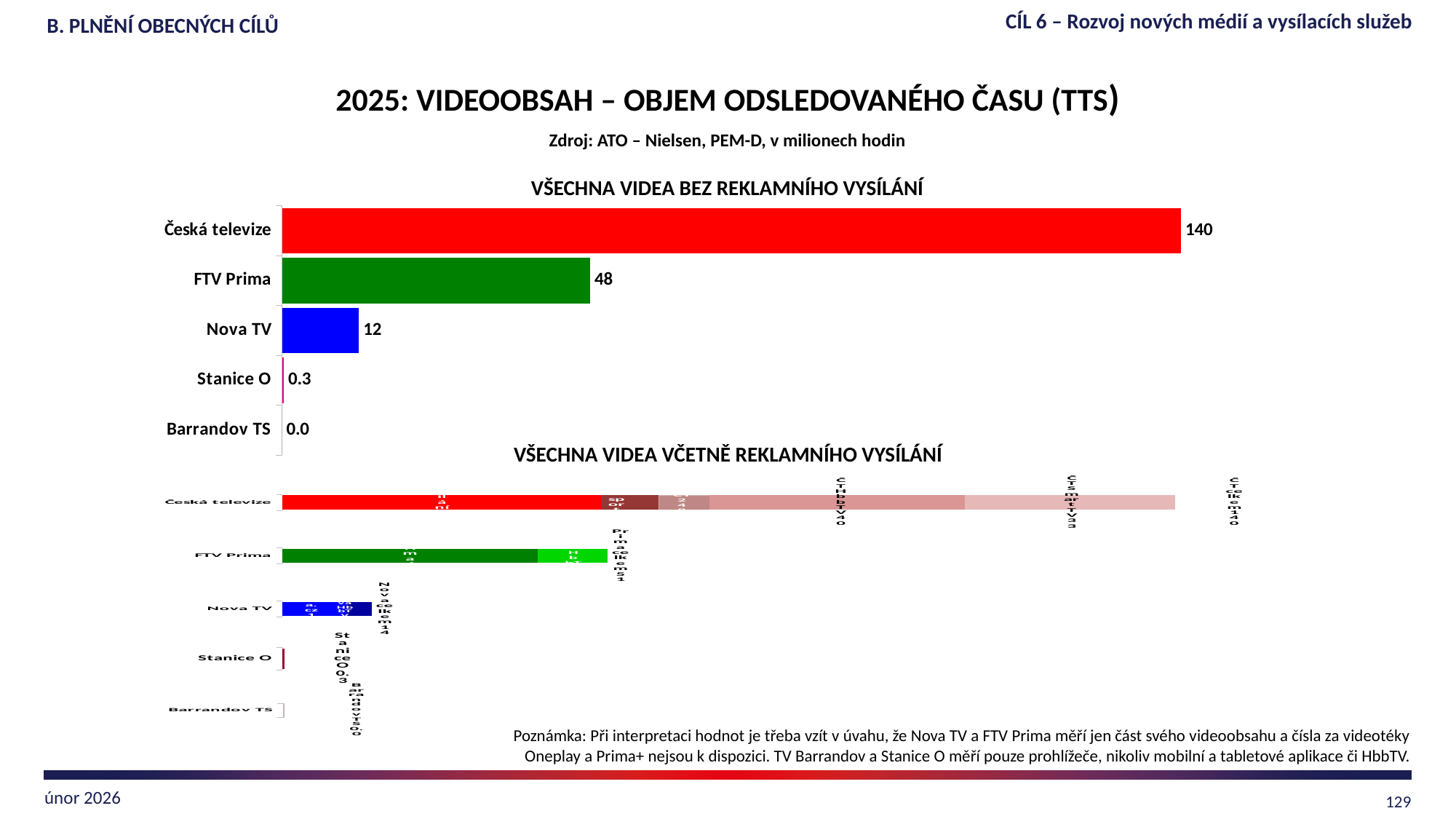
In the chart 'VŠECHNA VIDEA BEZ REKLAMNÍHO VYSÍLÁNÍ', what is the value for Barrandov TS? 0.0 What kind of chart is 'VŠECHNA VIDEA BEZ REKLAMNÍHO VYSÍLÁNÍ'? Bar chart In the chart 'VŠECHNA VIDEA BEZ REKLAMNÍHO VYSÍLÁNÍ', which category has the highest value? Česká televize In the chart 'VŠECHNA VIDEA BEZ REKLAMNÍHO VYSÍLÁNÍ', what is the value for Nova TV? 12 In the chart 'VŠECHNA VIDEA BEZ REKLAMNÍHO VYSÍLÁNÍ', what is the value for FTV Prima? 48 How many categories are shown in the chart 'VŠECHNA VIDEA BEZ REKLAMNÍHO VYSÍLÁNÍ'? 5 In the chart 'VŠECHNA VIDEA BEZ REKLAMNÍHO VYSÍLÁNÍ', which category has the lowest value? Barrandov TS In the chart 'VŠECHNA VIDEA BEZ REKLAMNÍHO VYSÍLÁNÍ', what is the difference between the values for Česká televize and FTV Prima? 92 In the chart 'VŠECHNA VIDEA BEZ REKLAMNÍHO VYSÍLÁNÍ', what is the value for Stanice O? 0.3 In the chart 'VŠECHNA VIDEA BEZ REKLAMNÍHO VYSÍLÁNÍ', what is the value for Česká televize? 140 In the chart 'VŠECHNA VIDEA BEZ REKLAMNÍHO VYSÍLÁNÍ', what is the difference between the values for FTV Prima and Nova TV? 36 In the chart 'VŠECHNA VIDEA BEZ REKLAMNÍHO VYSÍLÁNÍ', which is larger, the value for Nova TV or the value for Stanice O? Nova TV